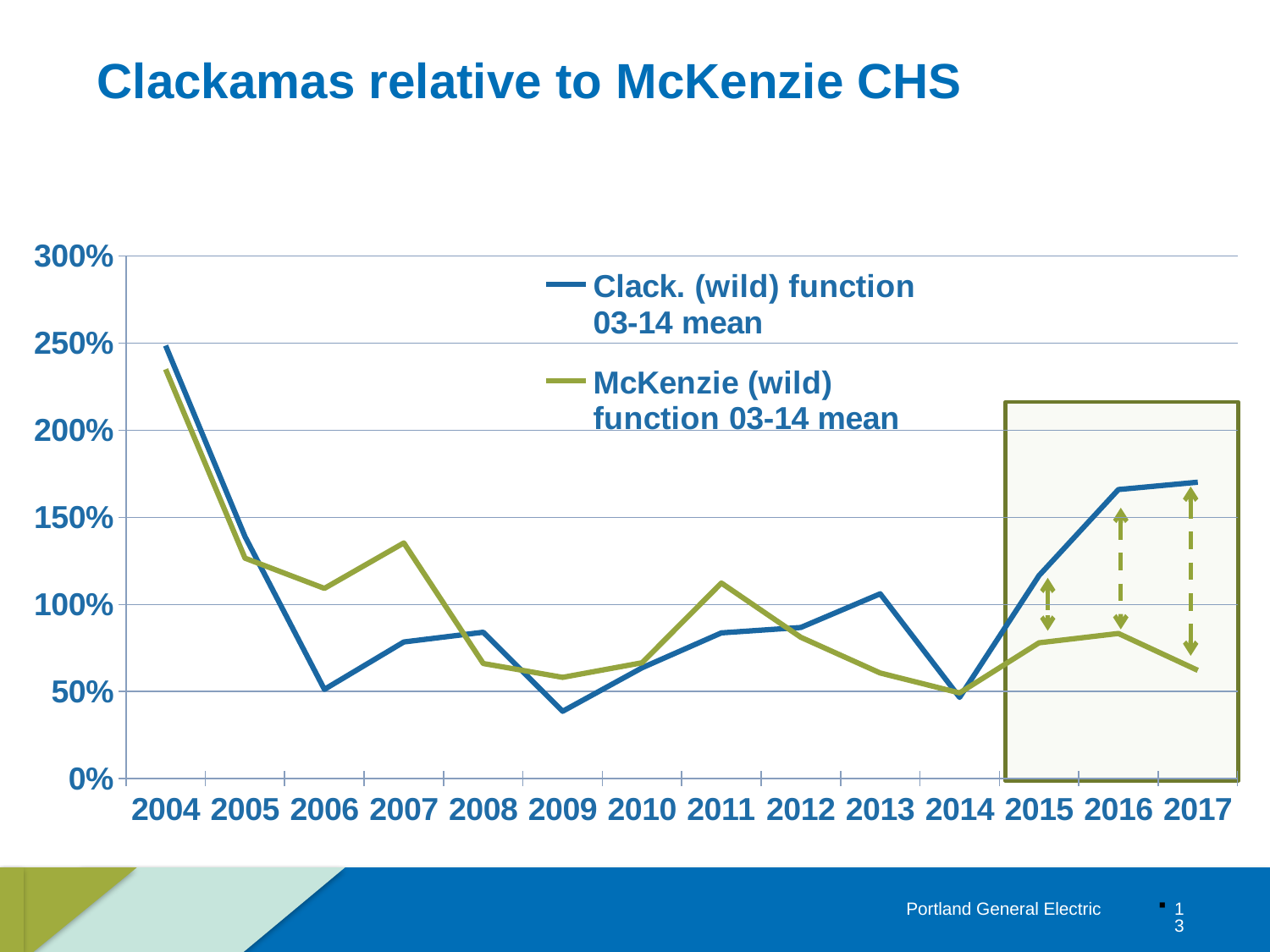
In which year is the Clack. (wild) function 03-14 mean series at its highest? 2004 In which year is the McKenzie (wild) function 03-14 mean series at its highest? 2004 Which series has the larger value in 2016, Clack. (wild) function 03-14 mean or McKenzie (wild) function 03-14 mean? Clack. (wild) function 03-14 mean In which year is the Clack. (wild) function 03-14 mean series at its lowest? 2009 How many years are plotted along the x axis? 14 Which series has the larger value in 2007, Clack. (wild) function 03-14 mean or McKenzie (wild) function 03-14 mean? McKenzie (wild) function 03-14 mean What kind of chart is shown on the slide? line chart Is the value for Clack. (wild) function 03-14 mean in 2009 greater or less than 50%? less Does the Clack. (wild) function 03-14 mean series rise or fall from 2014 to 2017? rise Is the value for Clack. (wild) function 03-14 mean in 2004 greater or less than 200%? greater How many series does the legend list? 2 Is the value for McKenzie (wild) function 03-14 mean in 2007 greater or less than 100%? greater